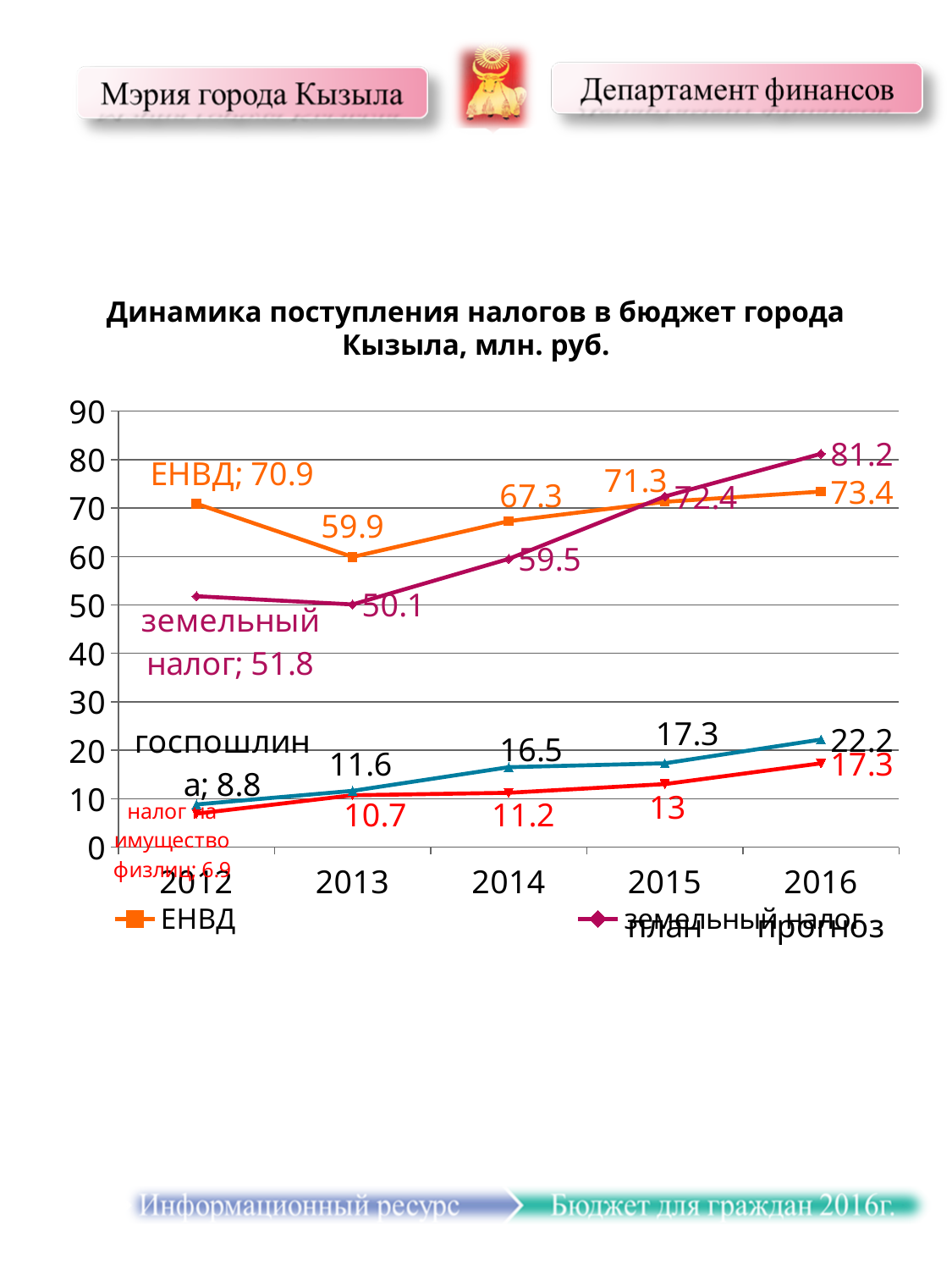
What is the value for ЕНВД in 2014? 67.3 In 2015, which is larger: ЕНВД or земельный налог? земельный налог What is the difference between the ЕНВД values for 2016 and 2012? 2.5 What is the value for земельный налог in 2016? 81.2 What is the value for госпошлина in 2015? 17.3 Does земельный налог rise or fall from 2013 to 2016? rises What is the value for налог на имущество физлиц in 2013? 10.7 In which year is земельный налог highest? 2016 In which year is ЕНВД lowest? 2013 What is the difference between the госпошлина values for 2016 and 2012? 13.4 How many years are shown on the x axis? 5 What kind of chart is shown on the slide? line chart